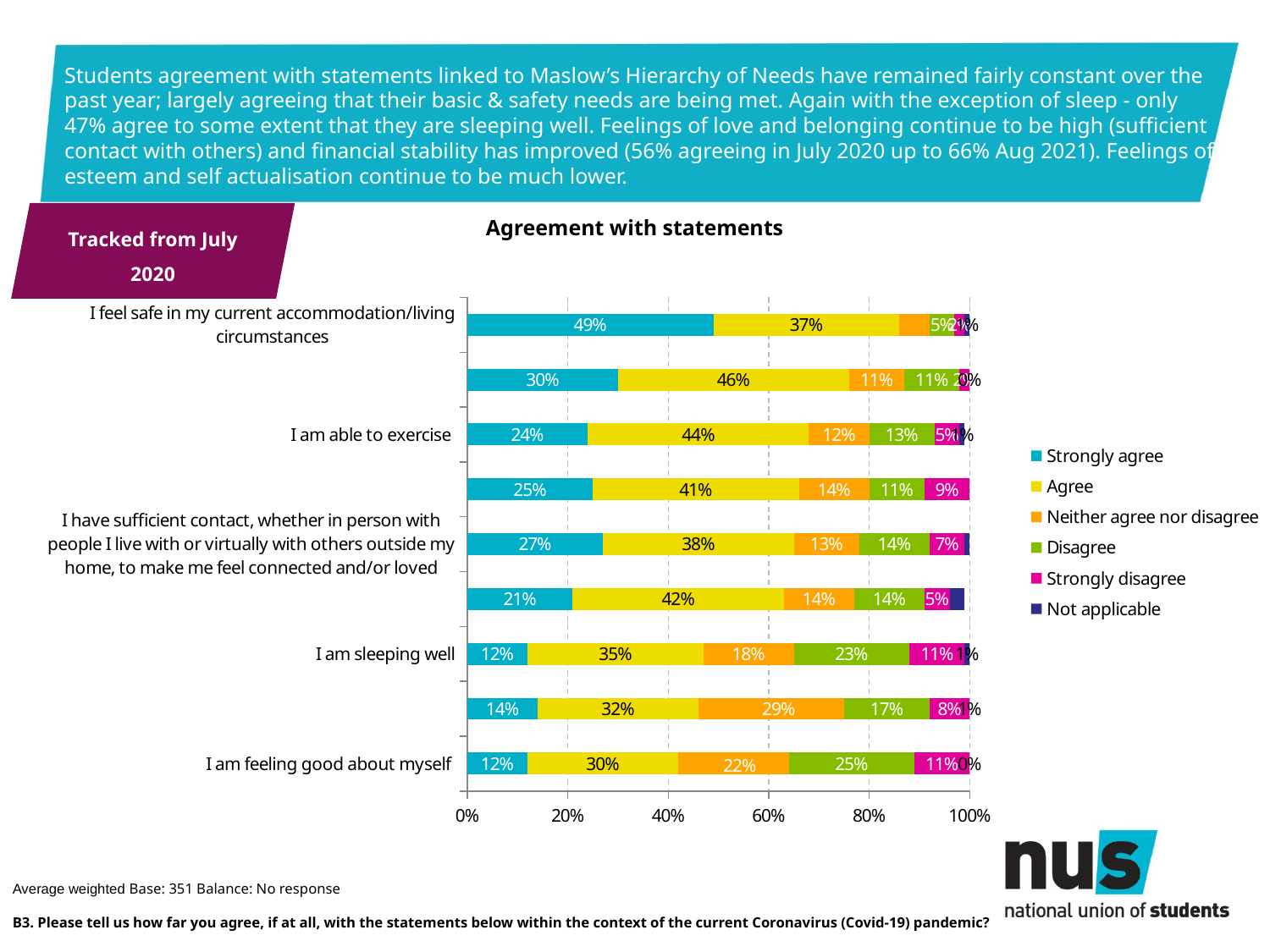
What is the 'Neither agree nor disagree' value for 'I am able to exercise'? 12% What is the title of the chart? Agreement with statements Which has the larger 'Agree' value: 'I am able to exercise' or 'I have sufficient contact, whether in person with people I live with or virtually with others outside my home, to make me feel connected and/or loved'? I am able to exercise What percentage of students strongly agree with 'I feel safe in my current accommodation/living circumstances'? 49% How many bars (statements) are plotted in the chart? 9 What is the 'Agree' value for 'I am sleeping well'? 35% What is the 'Strongly agree' value for 'I have sufficient contact, whether in person with people I live with or virtually with others outside my home, to make me feel connected and/or loved'? 27% What is the 'Disagree' value for 'I am feeling good about myself'? 25% Which statement has the highest 'Strongly agree' value? I feel safe in my current accommodation/living circumstances What kind of chart is shown on the slide? Stacked bar chart What is the difference in 'Strongly agree' between 'I feel safe in my current accommodation/living circumstances' and 'I am sleeping well'? 37 percentage points How many series does the legend of the chart list? 6